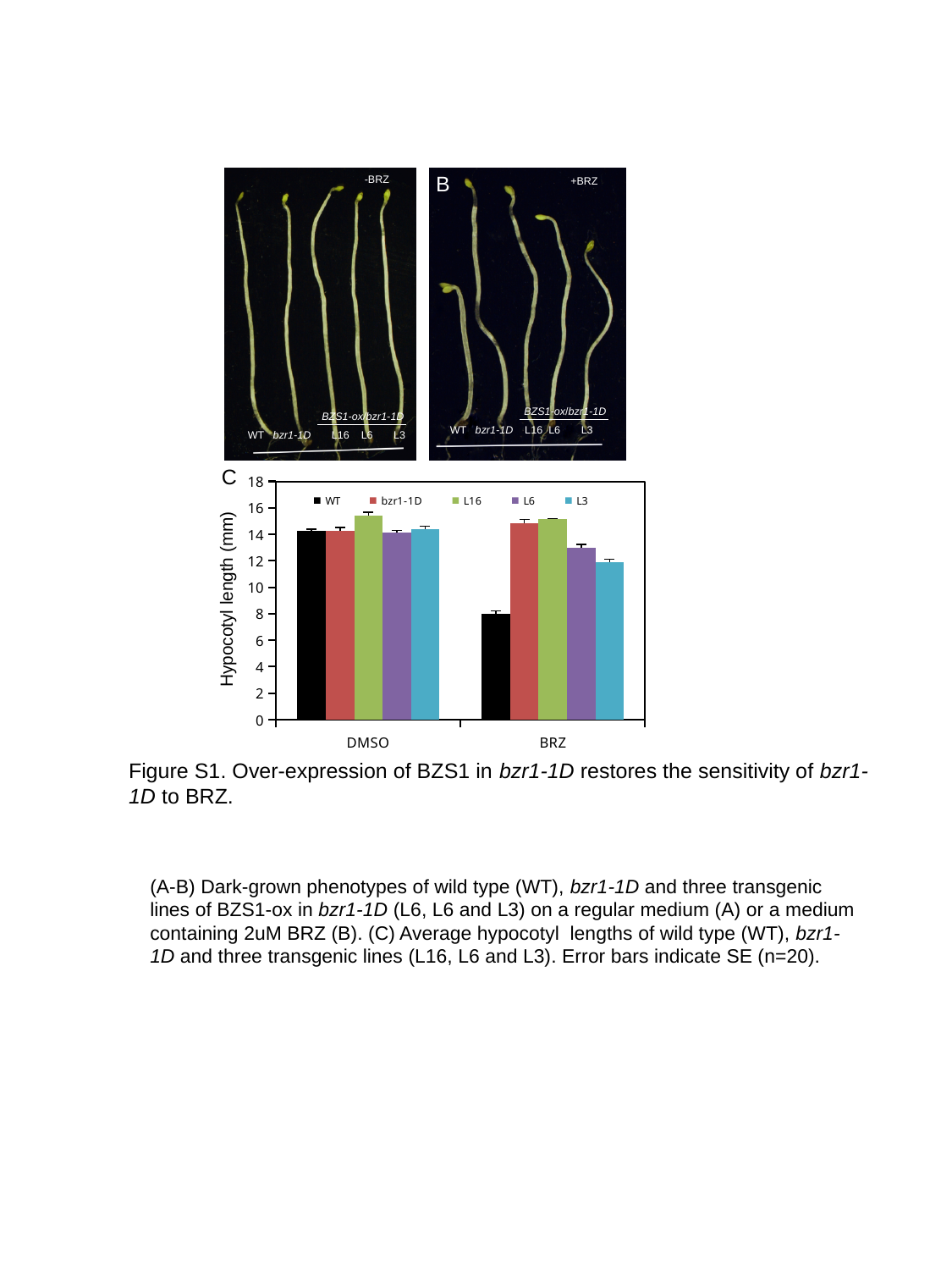
In chart C, what colour are the WT bars? black What kind of chart is panel C? bar chart In chart C, is the WT hypocotyl length larger under DMSO or under BRZ? DMSO In chart C, which line has the highest hypocotyl length under DMSO? L16 In chart C, is the hypocotyl length of L16 under DMSO greater or less than 14? greater In chart C, which line has the lowest hypocotyl length under BRZ? WT How many series does the legend of chart C list? 5 In chart C, is the hypocotyl length of WT under BRZ greater or less than 10? less How many treatment categories are shown on the x axis of chart C? 2 In chart C, under BRZ, which has the larger hypocotyl length, L6 or L3? L6 In chart C, is the hypocotyl length of L3 under BRZ greater or less than 14? less What is the y-axis label of chart C? Hypocotyl length (mm)